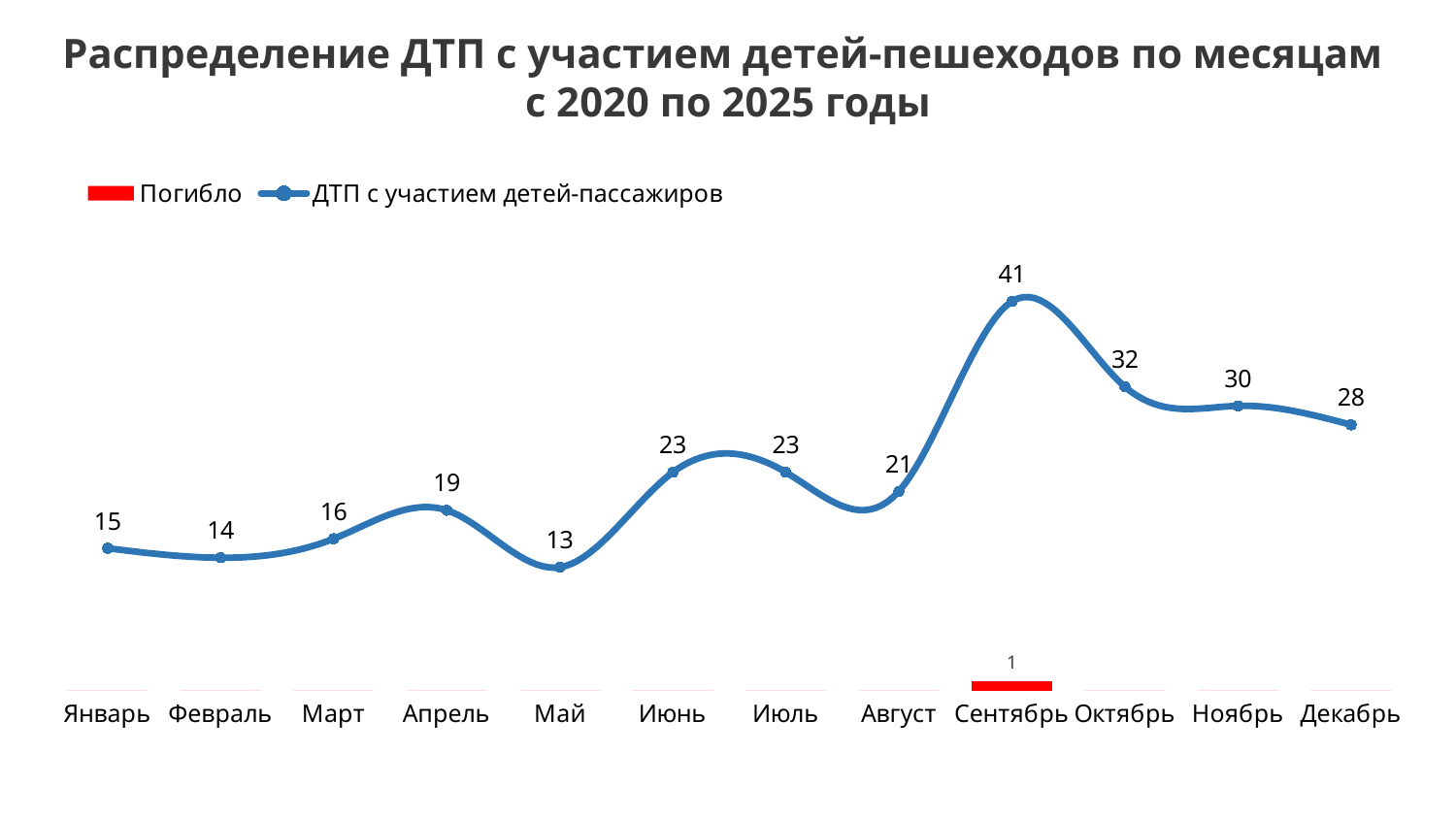
What is the value of the "Погибло" bar shown for Сентябрь? 1 What colour is the "Погибло" series in the legend? red Which month has a larger line value, Апрель or Август? Август Which month has the highest value on the line series "ДТП с участием детей-пассажиров"? Сентябрь Does the line series rise or fall from Сентябрь to Декабрь? fall Which month has the lowest value on the line series "ДТП с участием детей-пассажиров"? Май What is the value of the line series "ДТП с участием детей-пассажиров" for Май? 13 How many series does the legend list? 2 What is the difference between the line values for Сентябрь and Октябрь? 9 How many months are shown on the x axis? 12 What is the value of the line series "ДТП с участием детей-пассажиров" for Декабрь? 28 What is the value of the line series "ДТП с участием детей-пассажиров" for Сентябрь? 41